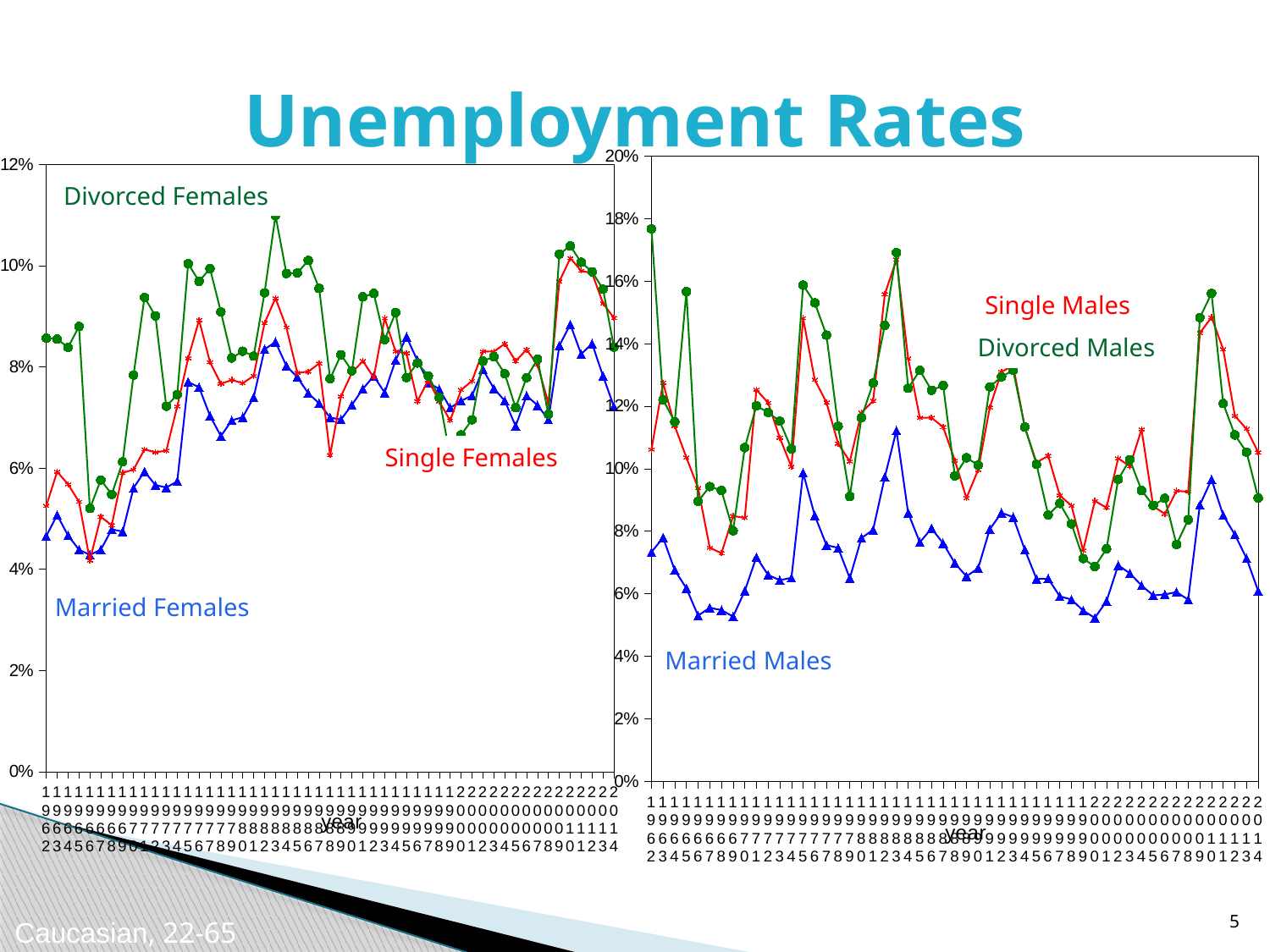
On the right chart, is the lowest value reached by Married Males greater or less than 6%? less How many series are plotted on the right chart? 3 On the left chart, is the highest value reached by Married Females greater or less than 8%? greater On the left chart, is the highest value reached by Divorced Females greater or less than 10%? greater What is the maximum value shown on the vertical axis of the right chart? 20% On the left chart, which series is generally the lowest across the years? Married Females On the right chart, which series is generally the lowest across the years? Married Males What is the title of the slide above the two charts? Unemployment Rates What kind of chart is the left chart on the slide? line chart How many series are plotted on the left chart? 3 What kind of chart is the right chart on the slide? line chart